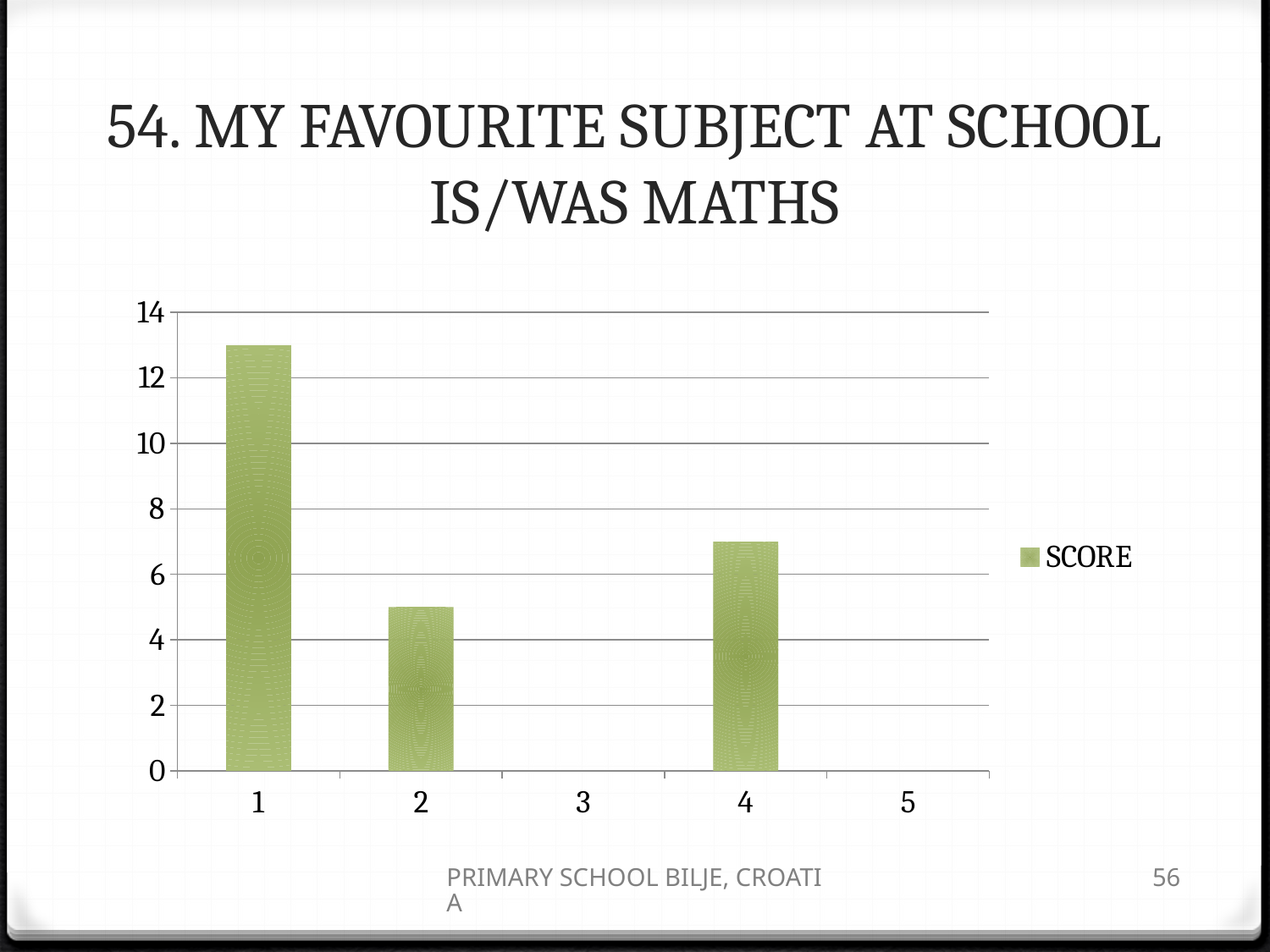
How many categories are shown on the x axis of the chart? 5 What kind of chart is shown on the slide? bar chart Which has a larger SCORE value, category 2 or category 4? 4 What is the SCORE value for category 5? 0 Is the SCORE value for category 1 greater or less than 12? greater What is the SCORE value for category 3? 0 Is the SCORE value for category 4 greater or less than 6? greater What is the name of the series shown in the legend? SCORE Is the SCORE value for category 2 greater or less than 6? less Which category has the highest SCORE value? 1 Which has a larger SCORE value, category 1 or category 2? 1 How many series does the chart's legend list? 1